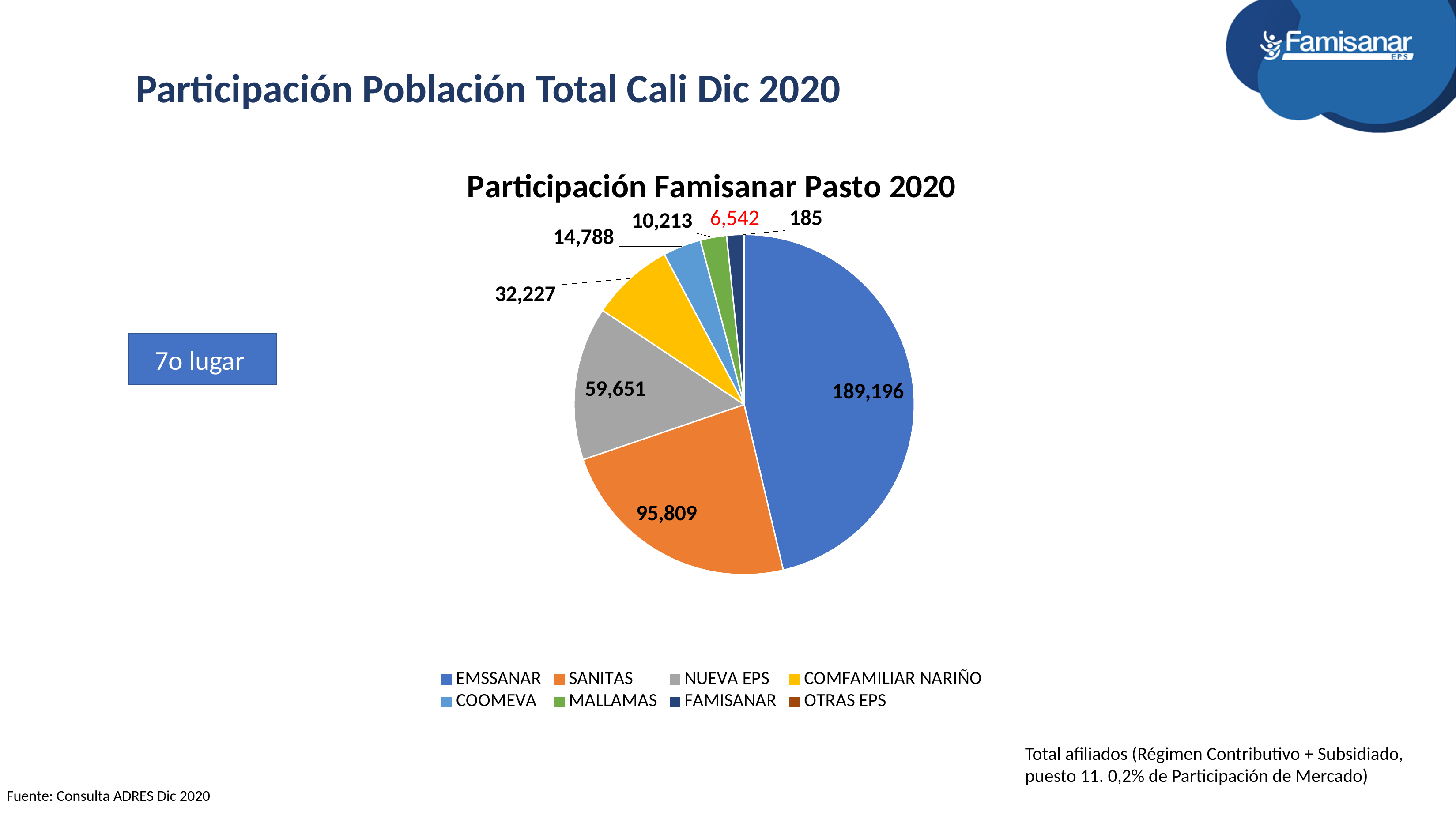
What is the title of the chart? Participación Famisanar Pasto 2020 What is the value of the EMSSANAR slice in the pie chart? 189,196 What value is shown for FAMISANAR in the pie chart? 6,542 What type of chart is shown on the slide? Pie chart How many slices does the pie chart have? 8 Which is larger, the NUEVA EPS slice or the COOMEVA slice? NUEVA EPS Which category has the smallest slice in the pie chart? OTRAS EPS What colour is the FAMISANAR slice in the pie chart? Dark navy blue What is the value shown for SANITAS in the pie chart? 95,809 What is the value of the COMFAMILIAR NARIÑO slice? 32,227 Which category has the largest slice in the pie chart? EMSSANAR What is the difference between the EMSSANAR and SANITAS values? 93,387